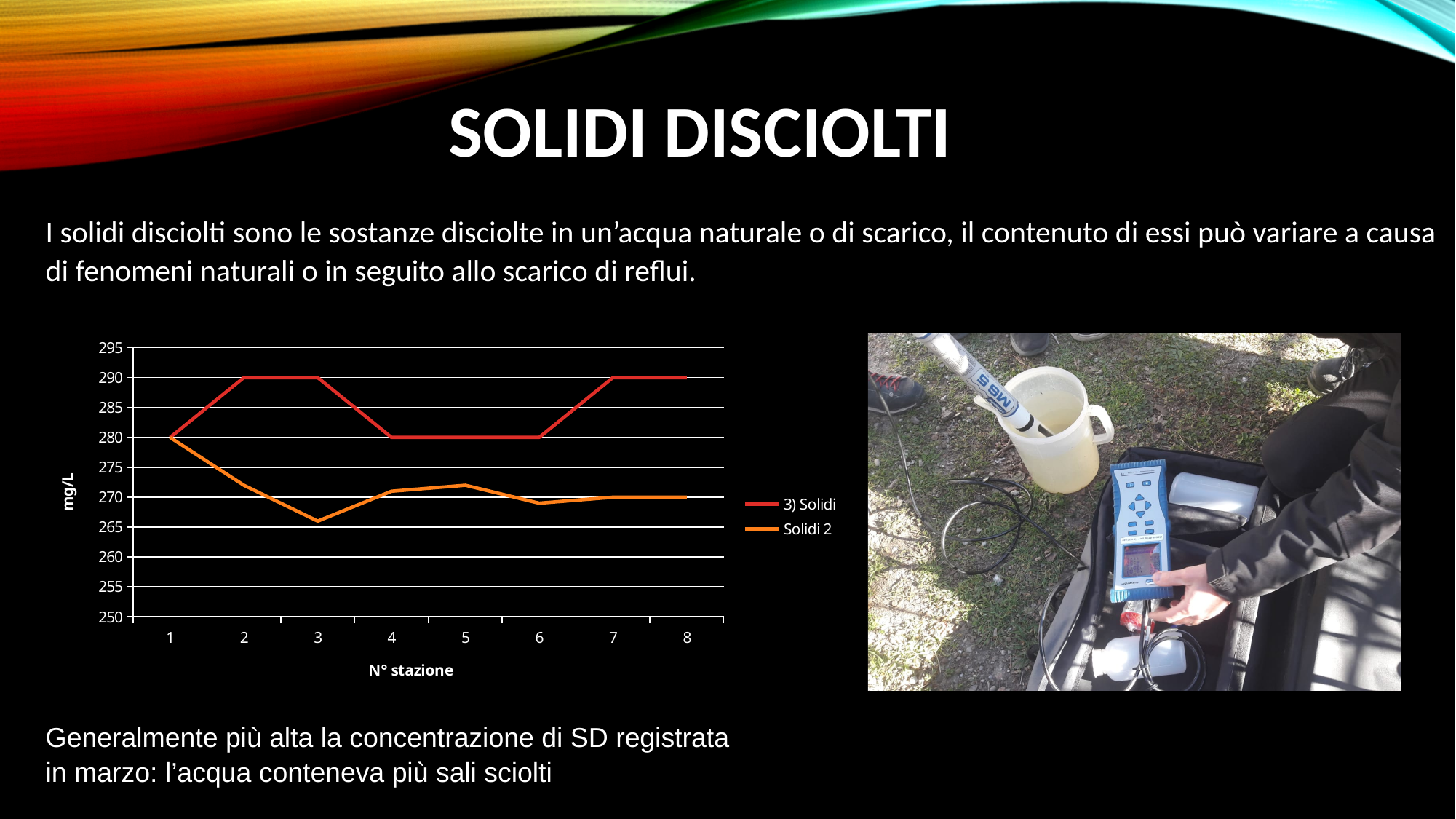
Is the value of 'Solidi 2' at station 3 greater or less than 270? less At which station does the 'Solidi 2' series reach its lowest value? 3 What is the value of the '3) Solidi' series at station 5? 280 At station 3, which series has the higher value, '3) Solidi' or 'Solidi 2'? 3) Solidi What is the label on the y axis of the chart? mg/L How many stations (N° stazione) are plotted along the x axis? 8 How many series does the chart legend list? 2 What is the value of the 'Solidi 2' series at station 1? 280 What is the value of the '3) Solidi' series at station 2? 290 What kind of chart is shown on the slide? line chart What is the difference between the '3) Solidi' value at station 2 and at station 4? 10 Is the value of 'Solidi 2' at station 5 greater or less than 275? less